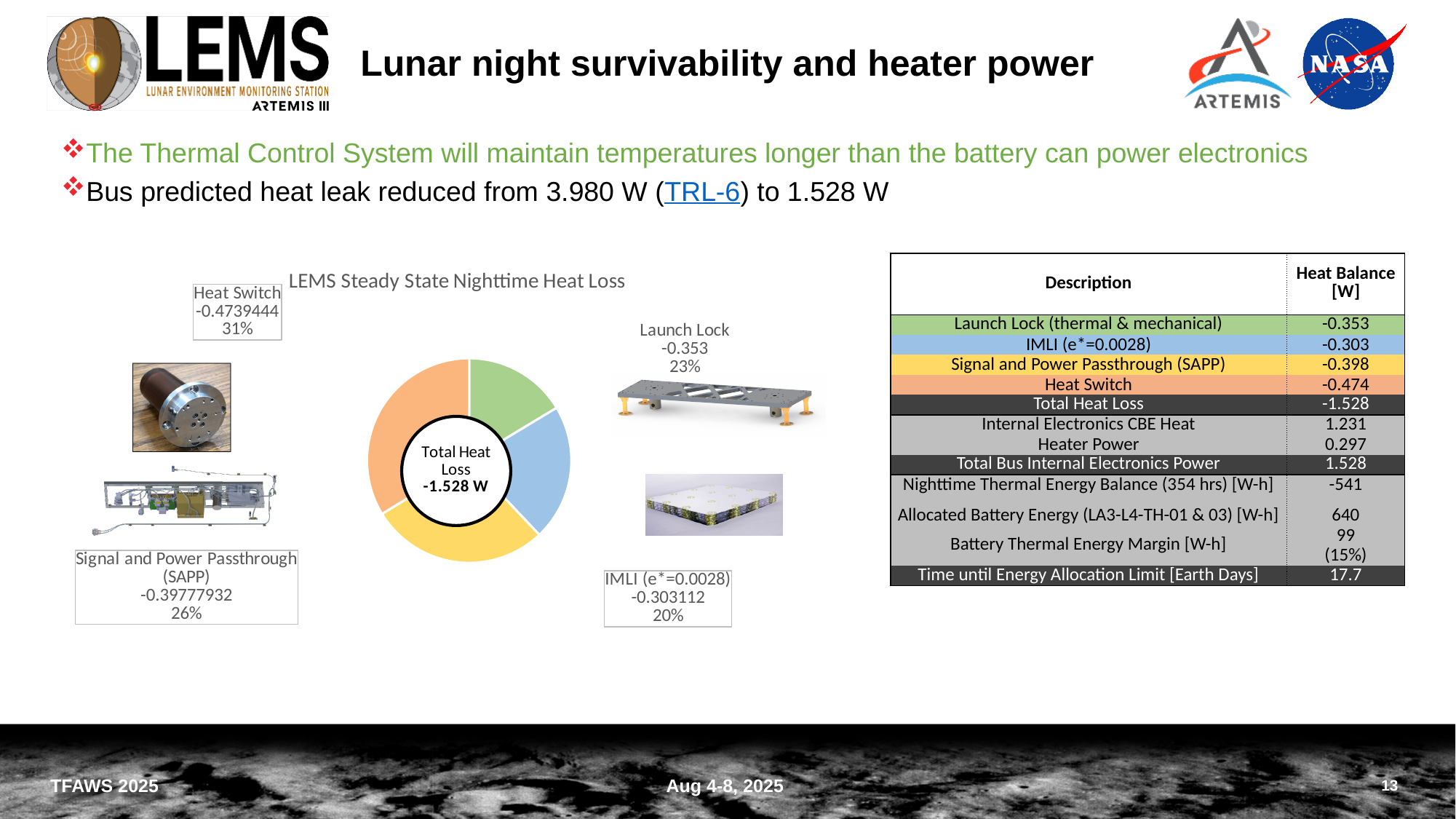
What share of the total heat loss does the Heat Switch slice represent? 31% What value is labelled for the Heat Switch slice in the heat loss chart? -0.4739444 What share of the total heat loss does the IMLI (e*=0.0028) slice represent? 20% Which component accounts for the smallest share of the nighttime heat loss in the chart? IMLI (e*=0.0028) What kind of chart is used to show the LEMS Steady State Nighttime Heat Loss? doughnut (pie) chart How many slices does the LEMS Steady State Nighttime Heat Loss chart have? 4 What value is labelled for the Signal and Power Passthrough (SAPP) slice in the heat loss chart? -0.39777932 What total heat loss is shown in the centre of the doughnut chart? -1.528 W Which component accounts for the largest share of the nighttime heat loss in the chart? Heat Switch What is the title of the chart on the slide? LEMS Steady State Nighttime Heat Loss What value is labelled for the Launch Lock slice in the heat loss chart? -0.353 What value is labelled for the IMLI (e*=0.0028) slice in the heat loss chart? -0.303112